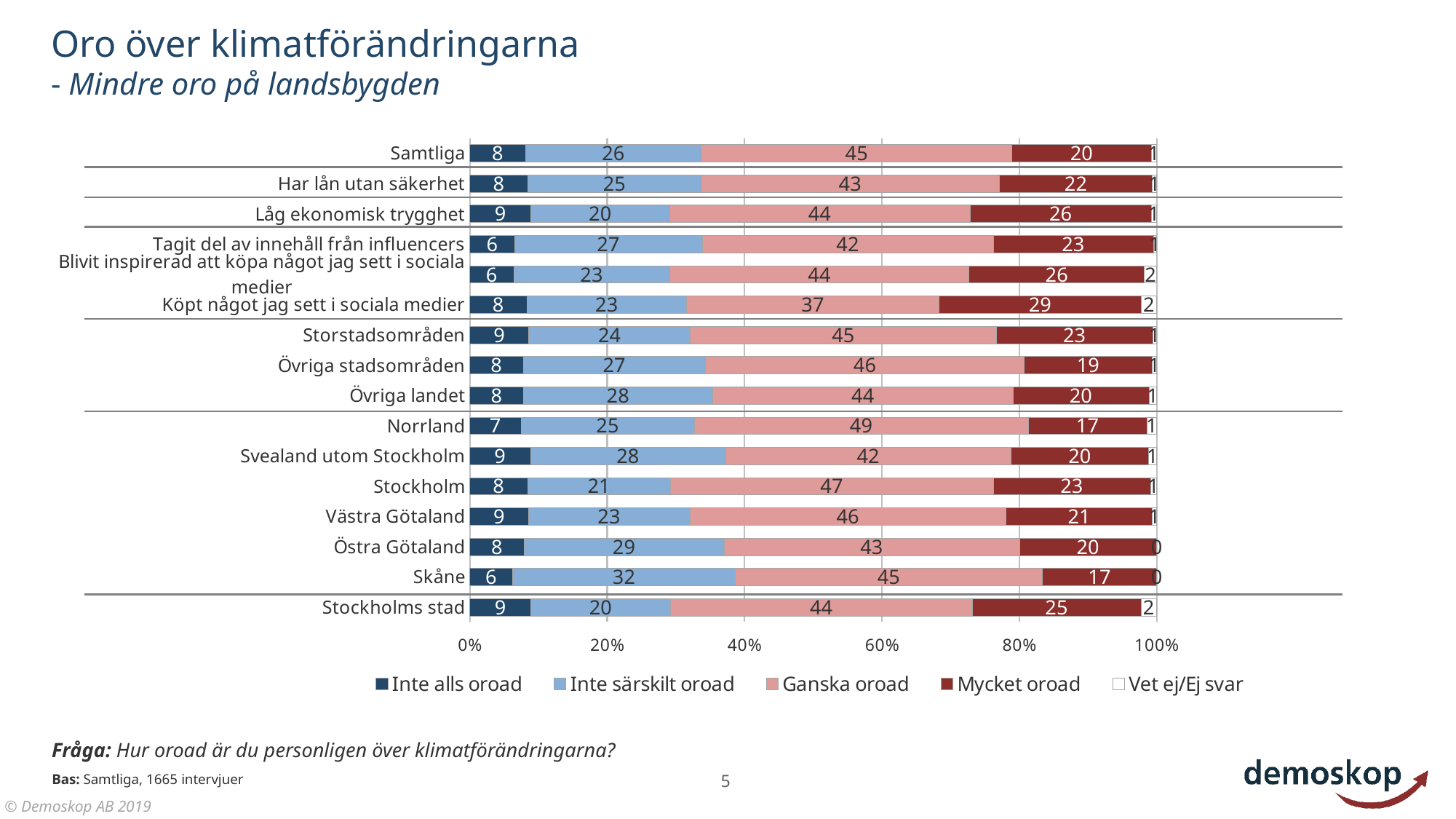
Which category has the highest value for 'Mycket oroad'? Köpt något jag sett i sociala medier How many categories are plotted on the chart? 16 What is the value of 'Vet ej/Ej svar' for Stockholms stad? 2 What kind of chart is shown on the slide? Stacked bar chart What is the value of 'Inte särskilt oroad' for Skåne? 32 Which legend entry is shown in the darkest red colour? Mycket oroad Which category has the lowest value for 'Ganska oroad'? Köpt något jag sett i sociala medier What is the value of 'Ganska oroad' for Norrland? 49 How many series does the legend list? 5 Which is larger: the 'Inte särskilt oroad' value for Östra Götaland or for Stockholm? Östra Götaland What is the value of 'Mycket oroad' for Samtliga? 20 What is the difference between the 'Mycket oroad' values for Låg ekonomisk trygghet and Samtliga? 6